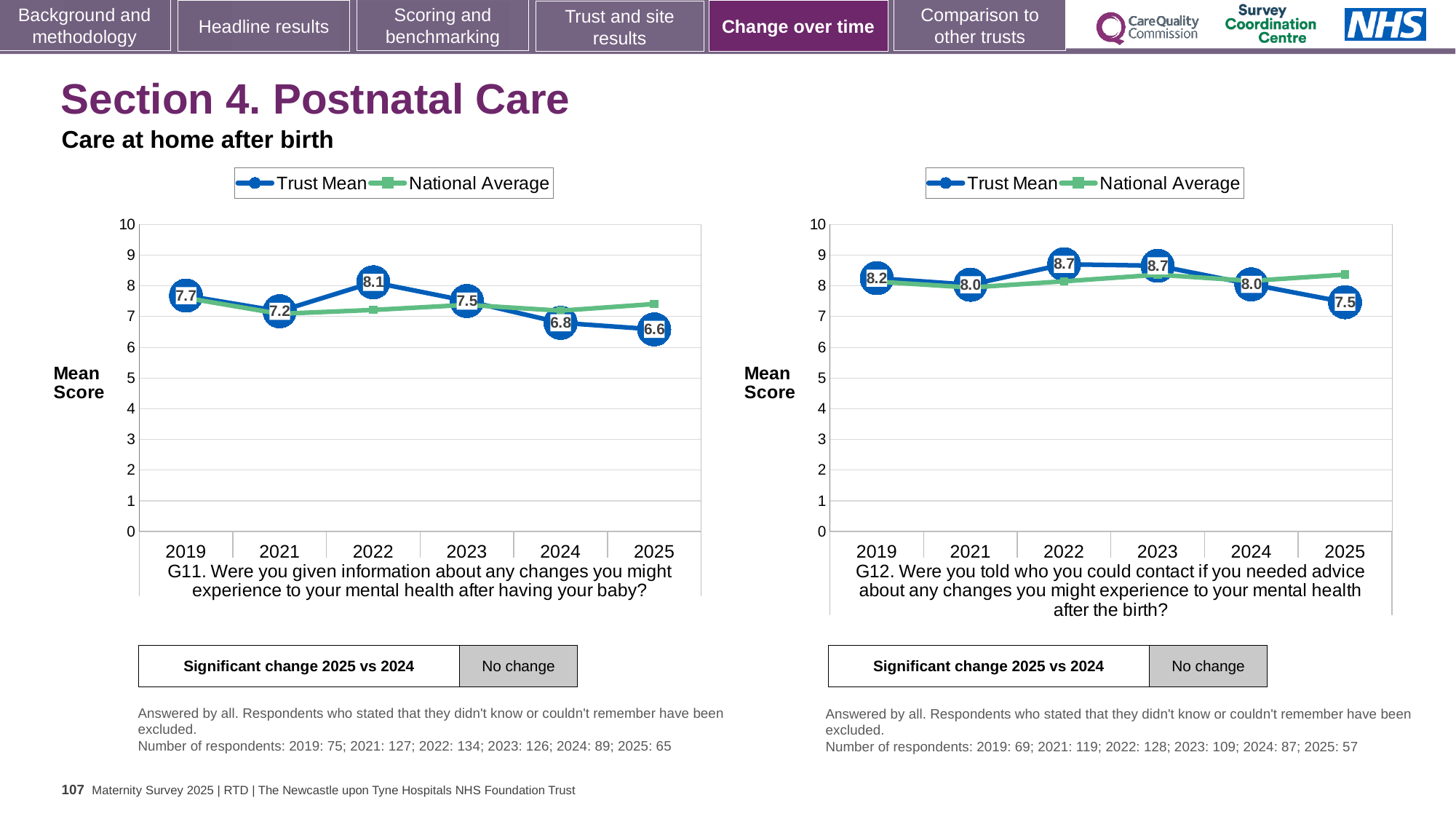
In the G11 chart on the left, what is the Trust Mean score for 2022? 8.1 In the G11 chart on the left, which year has the highest Trust Mean score? 2022 How many years are plotted on the x axis of the G12 chart on the right? 6 In the G11 chart on the left, is the National Average value for 2025 greater or less than 7? greater In the G11 chart on the left, which year has the lowest Trust Mean score? 2025 In the G12 chart on the right, is the Trust Mean score higher in 2019 or in 2021? 2019 In the G12 chart on the right, which year has the lowest Trust Mean score? 2025 In the G11 chart on the left, what is the difference between the Trust Mean scores for 2022 and 2025? 1.5 In the G12 chart on the right, what is the difference between the Trust Mean scores for 2019 and 2025? 0.7 What kind of chart is the G11 chart on the left? Line chart How many series does the legend of the G11 chart on the left list? 2 In the G12 chart on the right, what is the Trust Mean score for 2025? 7.5